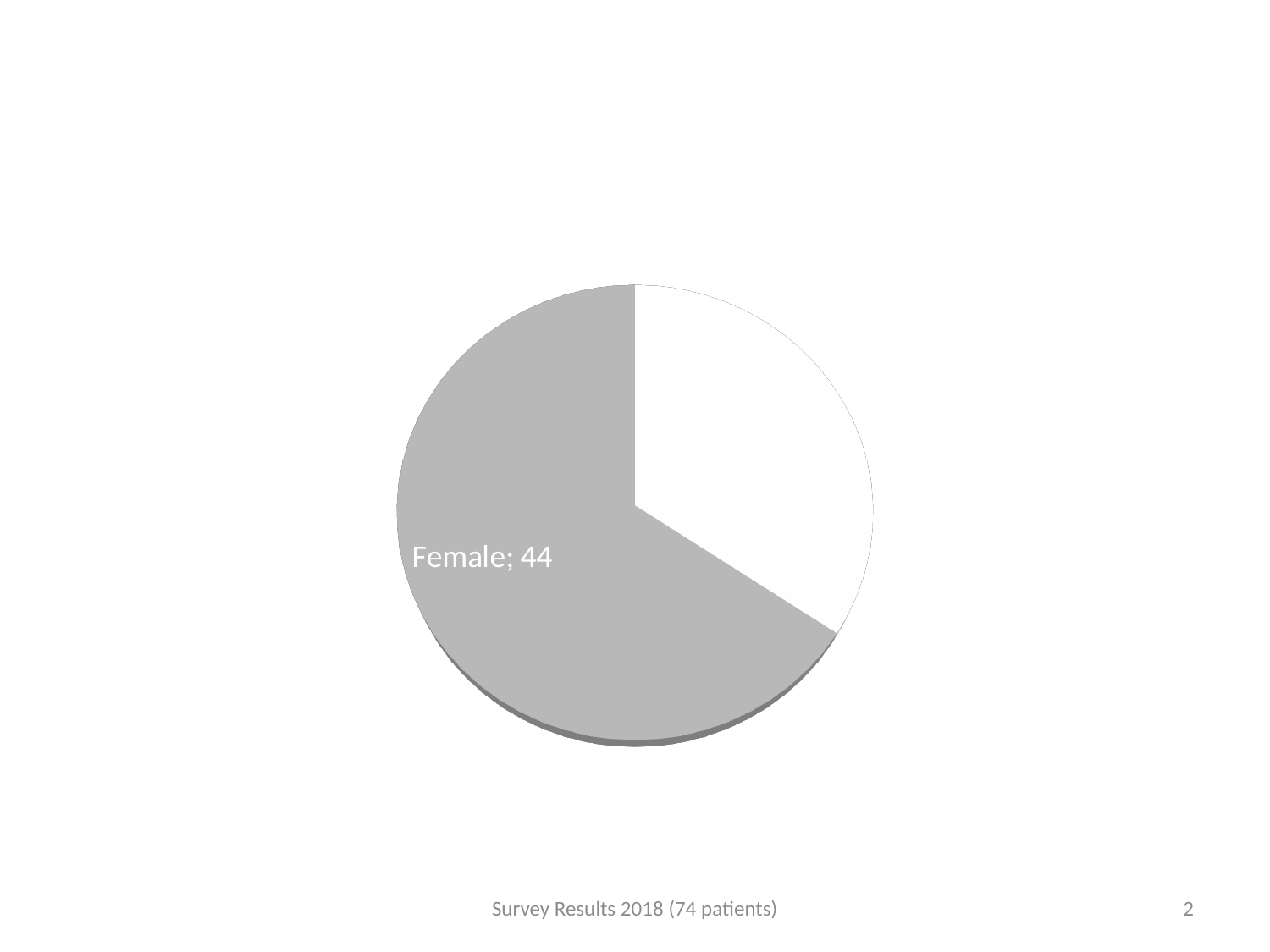
Is the Female slice larger or smaller than the unlabeled white slice? larger Which slice of the pie chart has a data label? Female What colour is the Female slice? grey Does the Female slice take up more or less than half of the pie? more How many slices does the pie chart have? 2 Which slice of the pie chart is the largest? Female What value is shown for the Female slice? 44 What kind of chart is shown on the slide? pie chart